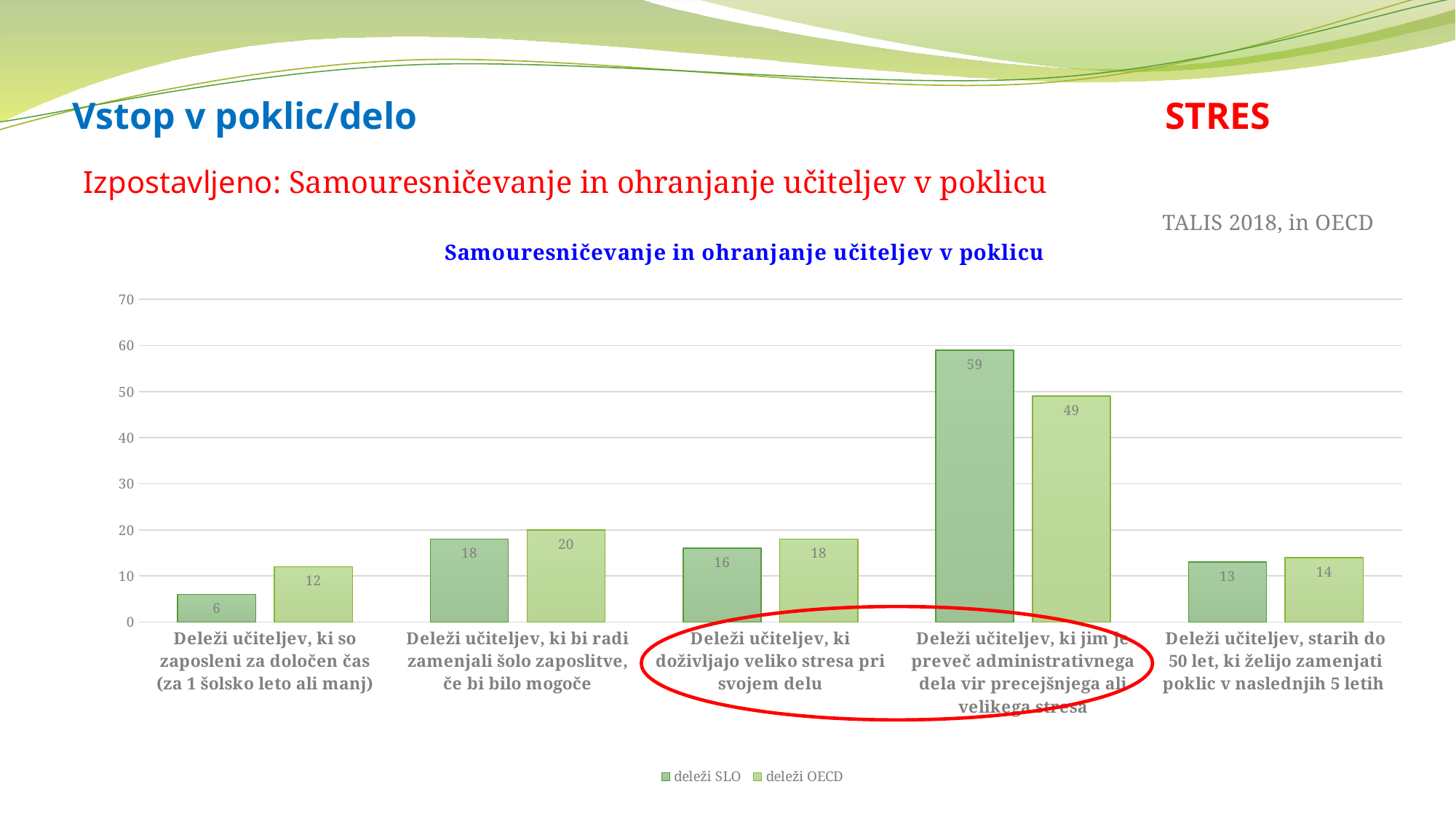
What is the difference between the 'deleži SLO' and 'deleži OECD' values for 'Deleži učiteljev, ki jim je preveč administrativnega dela vir precejšnjega ali velikega stresa'? 10 For 'Deleži učiteljev, ki bi radi zamenjali šolo zaposlitve, če bi bilo mogoče', which series has the larger value, 'deleži SLO' or 'deleži OECD'? deleži OECD What is the 'deleži OECD' value for 'Deleži učiteljev, ki so zaposleni za določen čas (za 1 šolsko leto ali manj)'? 12 Which category has the highest 'deleži OECD' value? Deleži učiteljev, ki jim je preveč administrativnega dela vir precejšnjega ali velikega stresa What is the 'deleži SLO' value for 'Deleži učiteljev, ki doživljajo veliko stresa pri svojem delu'? 16 What is the title of the chart? Samouresničevanje in ohranjanje učiteljev v poklicu How many series does the legend list? 2 Which category has the lowest 'deleži SLO' value? Deleži učiteljev, ki so zaposleni za določen čas (za 1 šolsko leto ali manj) What kind of chart is shown on the slide? Bar chart How many categories are shown on the x axis? 5 What is the 'deleži SLO' value for 'Deleži učiteljev, ki jim je preveč administrativnega dela vir precejšnjega ali velikega stresa'? 59 Is the 'deleži OECD' value for 'Deleži učiteljev, ki jim je preveč administrativnega dela vir precejšnjega ali velikega stresa' greater or less than 40? greater